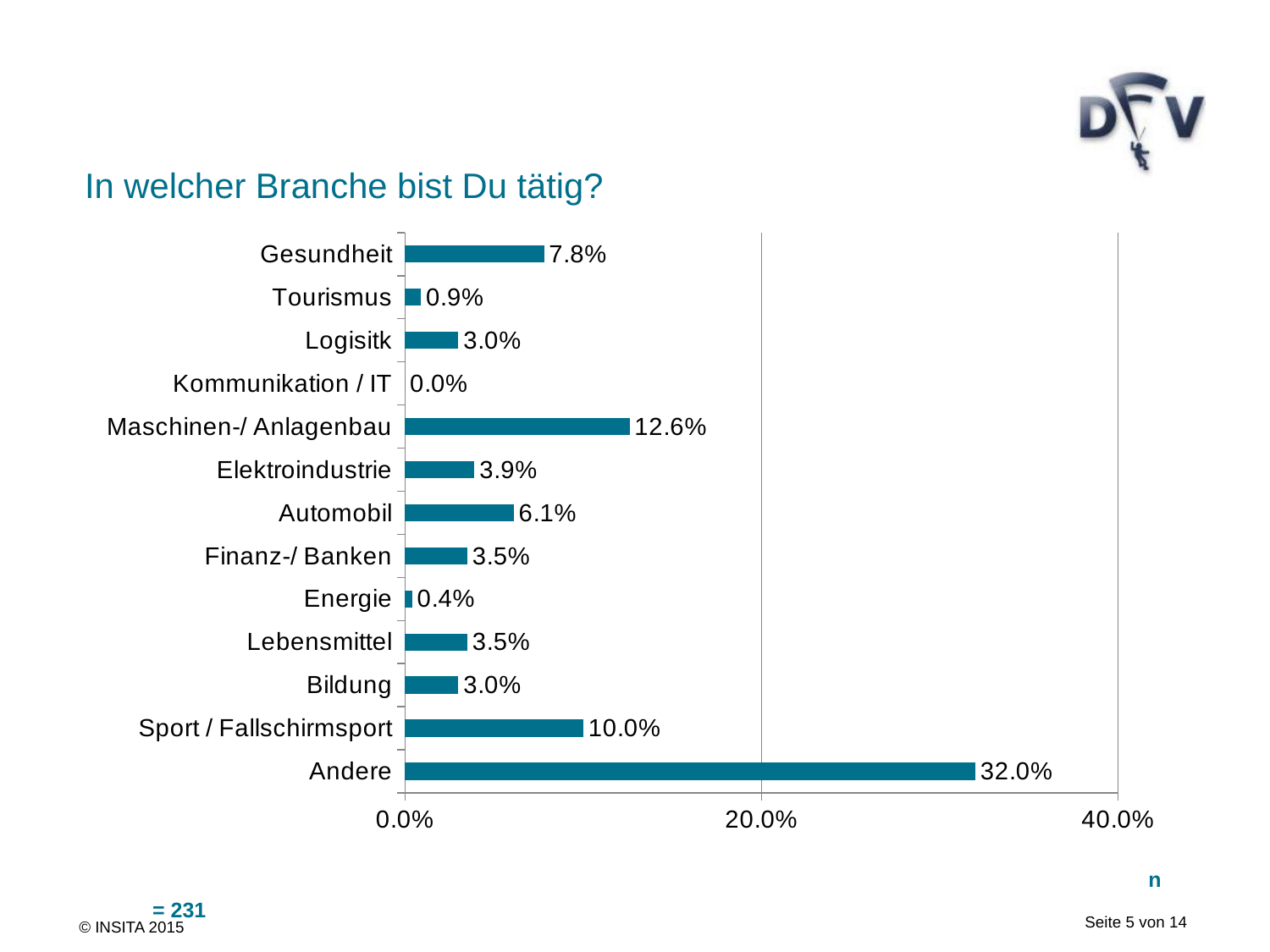
What is the title of the chart? In welcher Branche bist Du tätig? Is the value for Andere greater or less than 20.0%? greater What is the difference between the values for Gesundheit and Tourismus? 6.9% Which category has the highest value? Andere Which is larger, the value for Gesundheit or the value for Automobil? Gesundheit What is the value for Maschinen-/ Anlagenbau? 12.6% What kind of chart is shown on the slide? bar chart What is the value for Kommunikation / IT? 0.0% Which category has the lowest value? Kommunikation / IT What is the difference between the values for Andere and Sport / Fallschirmsport? 22.0% How many categories are shown in the chart? 13 What is the value for Sport / Fallschirmsport? 10.0%